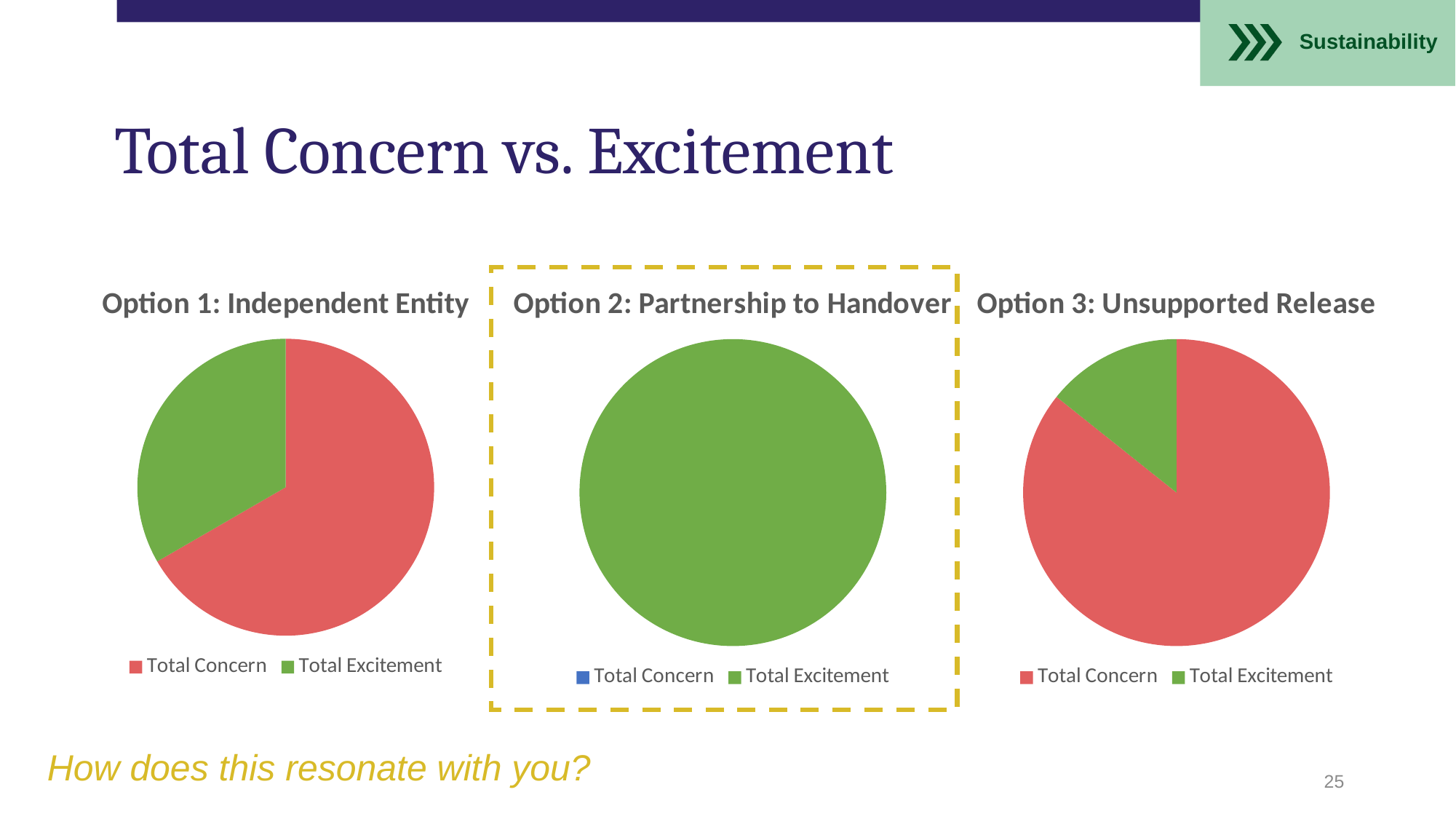
What is the title of the chart on the right of the slide? Option 3: Unsupported Release Which of the three charts shows the largest share for Total Excitement? Option 2: Partnership to Handover In the "Option 3: Unsupported Release" chart, which slice is larger, Total Concern or Total Excitement? Total Concern How many pie charts are shown on the slide? 3 What colour represents Total Excitement in the "Option 1: Independent Entity" chart? Green In the "Option 2: Partnership to Handover" chart, which category takes up the whole pie? Total Excitement How many entries does the legend of the "Option 1: Independent Entity" chart list? 2 What kind of chart is used for "Option 1: Independent Entity"? Pie chart How many entries does the legend of the "Option 3: Unsupported Release" chart list? 2 In the "Option 1: Independent Entity" chart, which slice is larger, Total Concern or Total Excitement? Total Concern In the "Option 3: Unsupported Release" chart, which slice is smaller, Total Concern or Total Excitement? Total Excitement